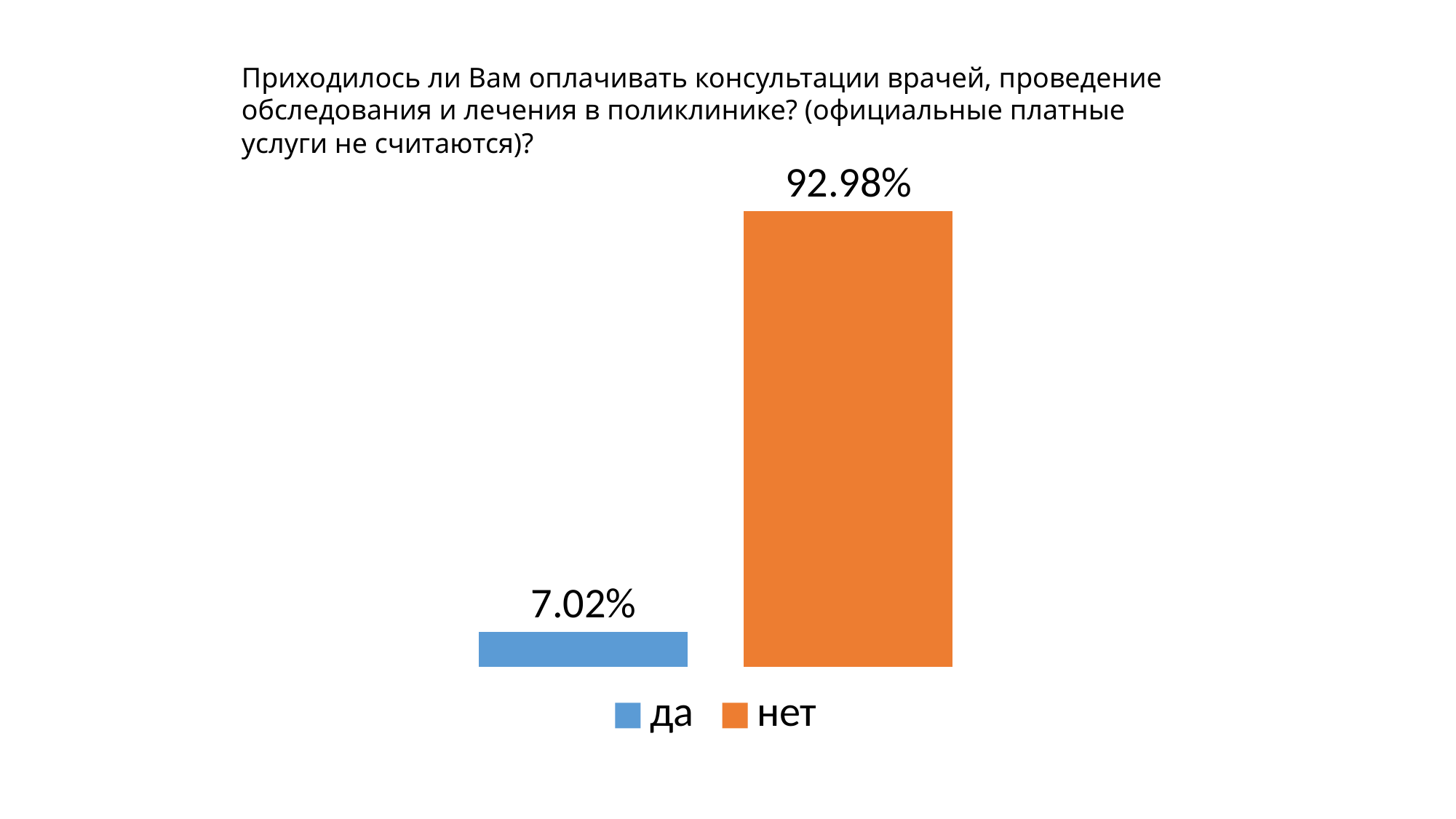
What is the value for "нет"? 92.98% Which category has the lowest value? да What is the total of the two values shown in the chart? 100% What kind of chart is shown on the slide? bar chart What is the value for "да"? 7.02% How many categories are shown in the chart? 2 What colour is the bar for "нет"? orange Which is larger, the value for "да" or the value for "нет"? нет Which category has the highest value? нет How many entries does the legend list? 2 What is the difference between the values for "нет" and "да"? 85.96% What colour is the bar for "да"? blue